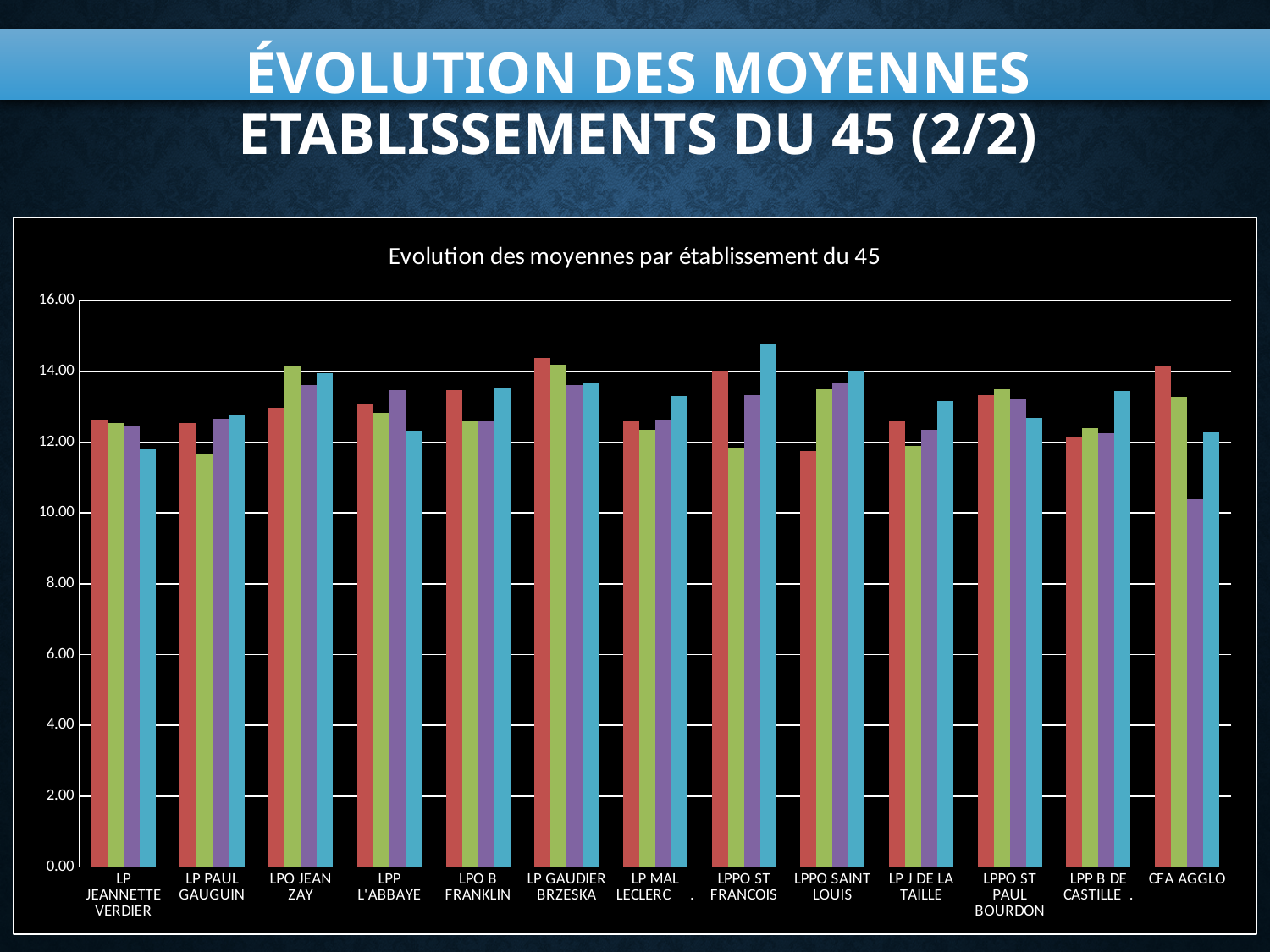
Is the value of the blue (rightmost) bar for LPPO ST FRANCOIS greater or less than 14.00? greater Is the value of the purple (third) bar for CFA AGGLO greater or less than 12.00? less What is the title of the chart? Evolution des moyennes par établissement du 45 Which establishment has the single tallest bar in the chart? LPPO ST FRANCOIS How many bars are plotted for each establishment in the chart? 4 What kind of chart is shown on the slide? bar chart Is the value of the red (first) bar for LP GAUDIER BRZESKA greater or less than 14.00? greater Which is larger: the red (first) bar for LP GAUDIER BRZESKA or the red (first) bar for LP JEANNETTE VERDIER? LP GAUDIER BRZESKA Which establishment has the single shortest bar in the chart? CFA AGGLO What is the highest value shown on the vertical axis of the chart? 16.00 How many establishments (categories) are shown on the x axis of the chart? 13